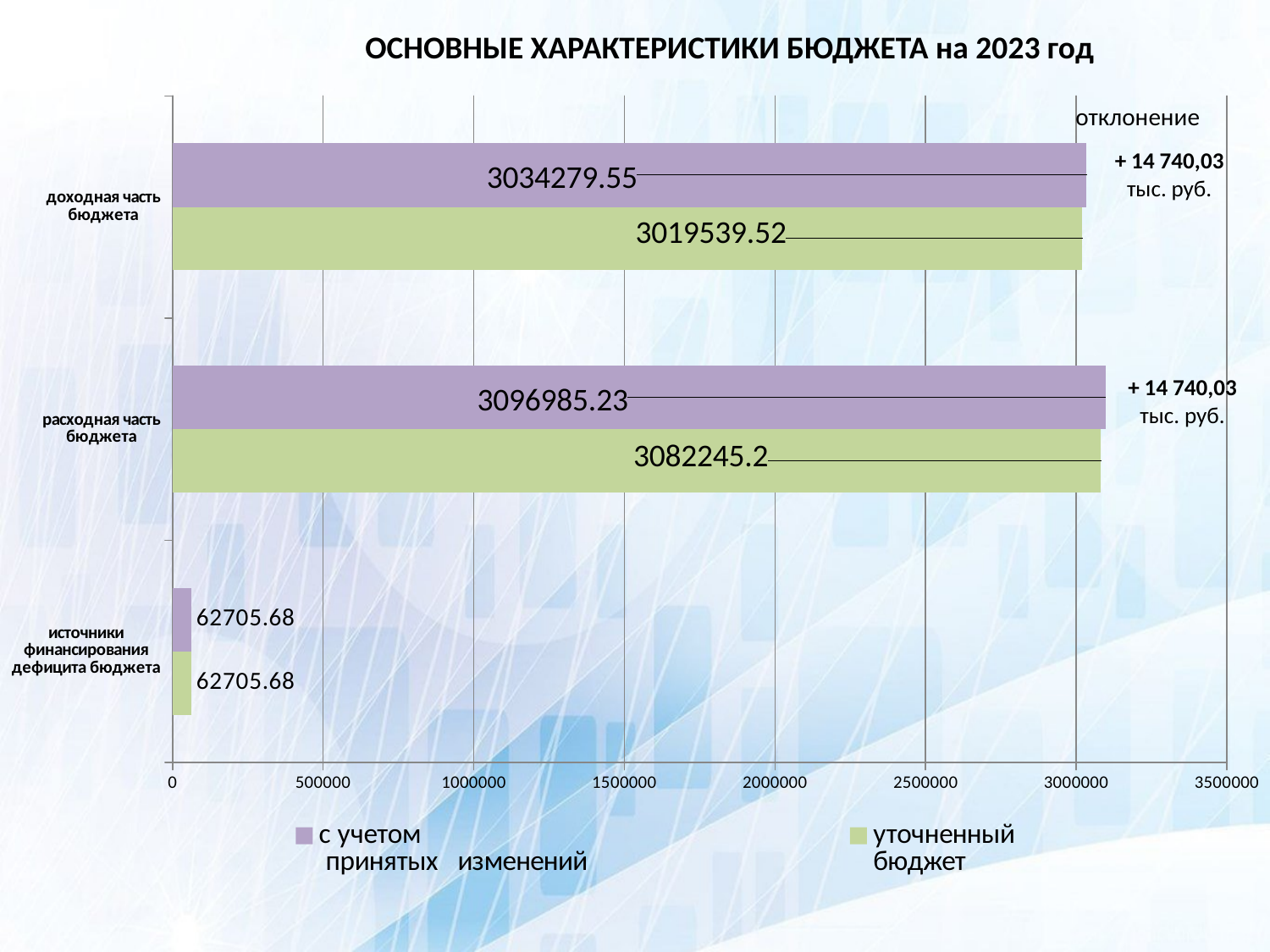
What is the value of 'уточненный бюджет' for 'источники финансирования дефицита бюджета'? 62705.68 How many categories are shown on the chart? 3 What type of chart is shown on the slide? bar chart Which category has the highest value for 'с учетом принятых изменений'? расходная часть бюджета What is the difference between 'с учетом принятых изменений' and 'уточненный бюджет' for 'доходная часть бюджета'? 14740.03 What is the value of 'с учетом принятых изменений' for 'доходная часть бюджета'? 3034279.55 Which category has the lowest value for 'уточненный бюджет'? источники финансирования дефицита бюджета What is the value of 'уточненный бюджет' for 'расходная часть бюджета'? 3082245.2 What is the title of the chart? ОСНОВНЫЕ ХАРАКТЕРИСТИКИ БЮДЖЕТА на 2023 год For 'расходная часть бюджета', which is larger: 'с учетом принятых изменений' or 'уточненный бюджет'? с учетом принятых изменений How many series does the legend list? 2 Is the value of 'уточненный бюджет' for 'доходная часть бюджета' greater or less than 3000000? greater